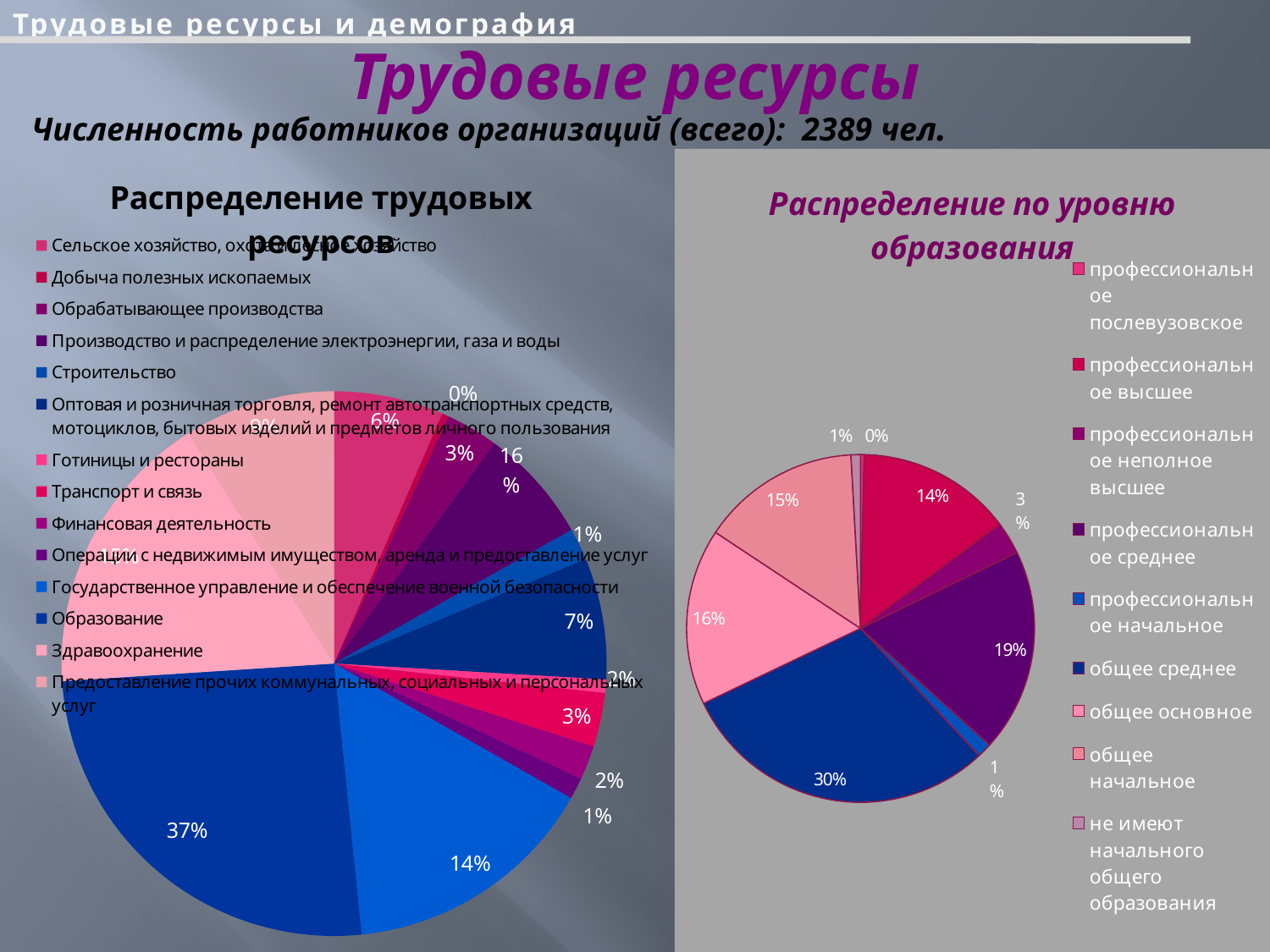
In the right pie chart "Распределение по уровню образования", which category has the largest share? общее среднее In the right pie chart "Распределение по уровню образования", what share does общее среднее have? 30% In the left pie chart "Распределение трудовых ресурсов", what share does Образование have? 37% In the left pie chart "Распределение трудовых ресурсов", what share does Государственное управление и обеспечение военной безопасности have? 14% In the right pie chart "Распределение по уровню образования", what share does профессиональное среднее have? 19% In the left pie chart "Распределение трудовых ресурсов", which category has the largest share? Образование How many categories does the legend of the right pie chart "Распределение по уровню образования" list? 9 In the right pie chart "Распределение по уровню образования", what is the difference between the shares of общее среднее and профессиональное среднее? 11% How many categories does the legend of the left pie chart "Распределение трудовых ресурсов" list? 14 In the right pie chart "Распределение по уровню образования", what share does профессиональное высшее have? 14% What type of chart is used for "Распределение трудовых ресурсов" on the left of the slide? pie chart In the left pie chart "Распределение трудовых ресурсов", what share does Производство и распределение электроэнергии, газа и воды have? 16%